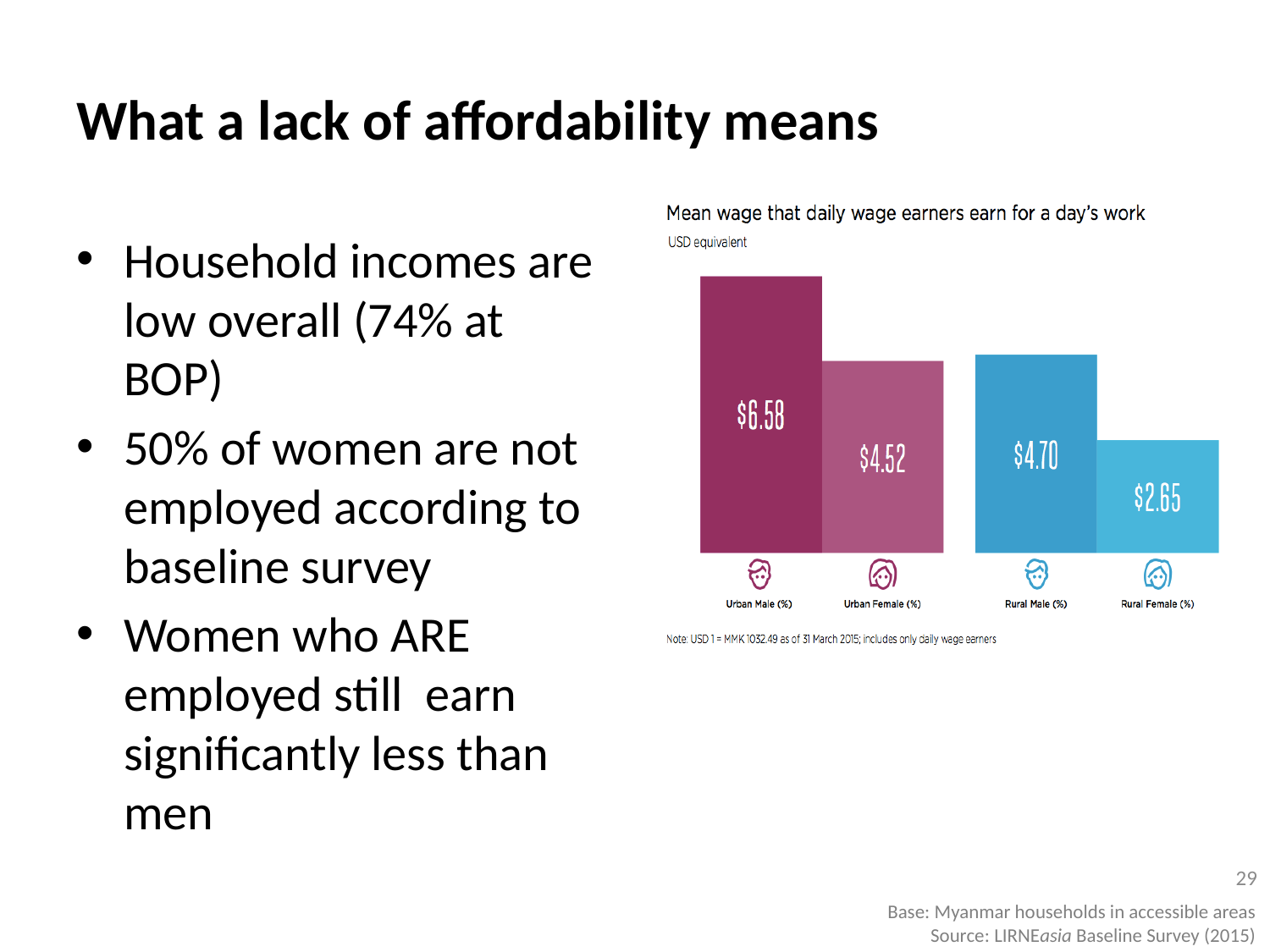
What is the mean daily wage shown for Urban Male? $6.58 Which category has the highest mean daily wage? Urban Male What kind of chart is shown on the slide? Bar chart Which is larger, the mean daily wage for Urban Female or for Rural Male? Rural Male What is the difference between the Urban Male and Urban Female mean daily wages? $2.06 What is the mean daily wage shown for Rural Female? $2.65 What is the difference between the Rural Male and Rural Female mean daily wages? $2.05 Which category has the lowest mean daily wage? Rural Female What is the mean daily wage shown for Urban Female? $4.52 What is the title of the chart? Mean wage that daily wage earners earn for a day's work How many categories are shown in the chart? 4 What is the mean daily wage shown for Rural Male? $4.70